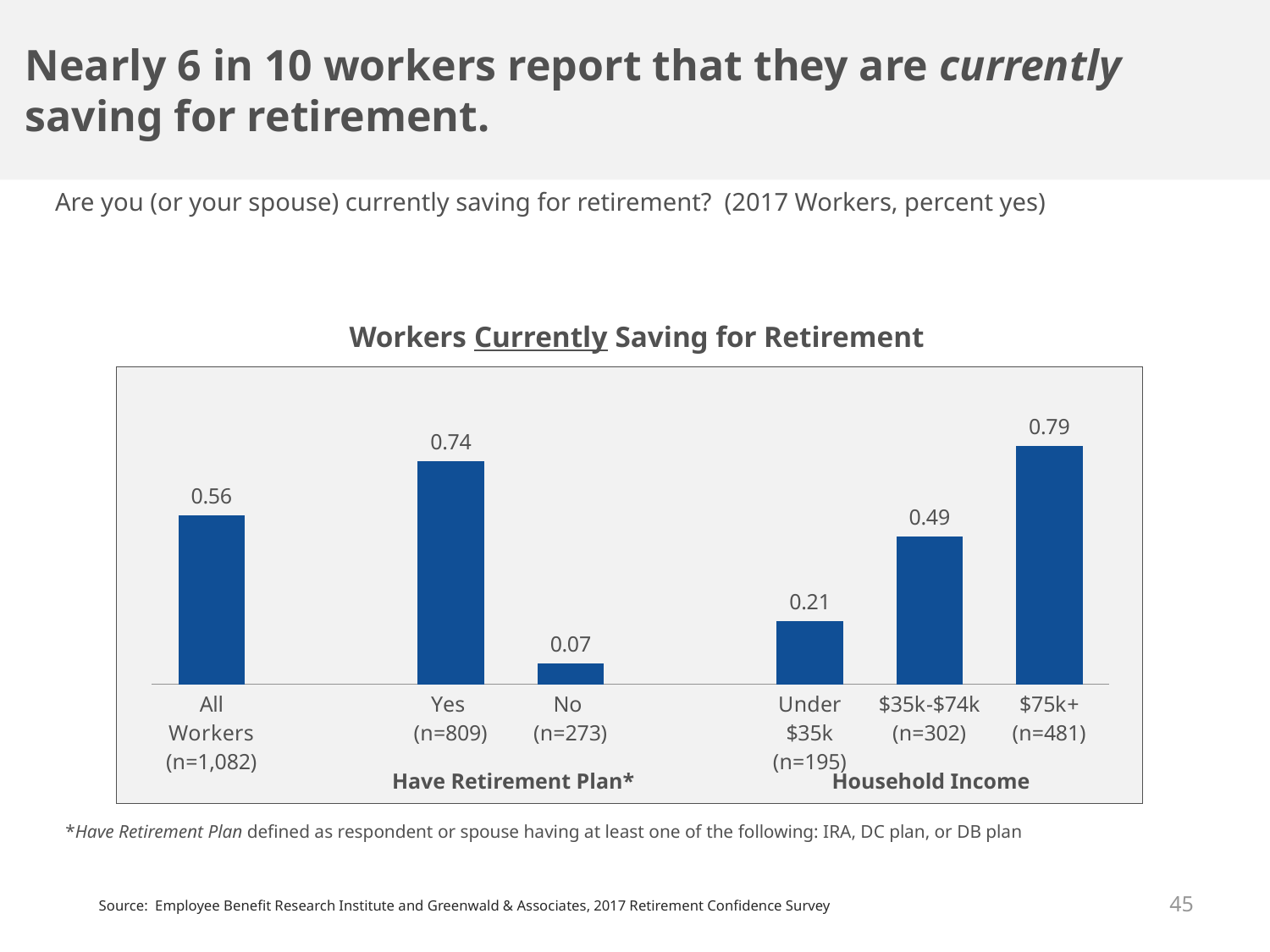
What is the value for workers who have a retirement plan (Yes, n=809)? 0.74 What is the value for workers with household income under $35k (n=195)? 0.21 What is the value for All Workers (n=1,082)? 0.56 Which is larger, the value for $35k-$74k or the value for All Workers? All Workers What is the difference between the Yes (n=809) and No (n=273) values under Have Retirement Plan? 0.67 What is the title of the chart? Workers Currently Saving for Retirement Which category has the highest value? $75k+ (n=481) What kind of chart is shown? Bar chart How many bars are plotted in the chart? 6 Which category has the lowest value? No (n=273) What is the difference between the $75k+ and Under $35k household income values? 0.58 What is the value for workers with household income of $75k+ (n=481)? 0.79